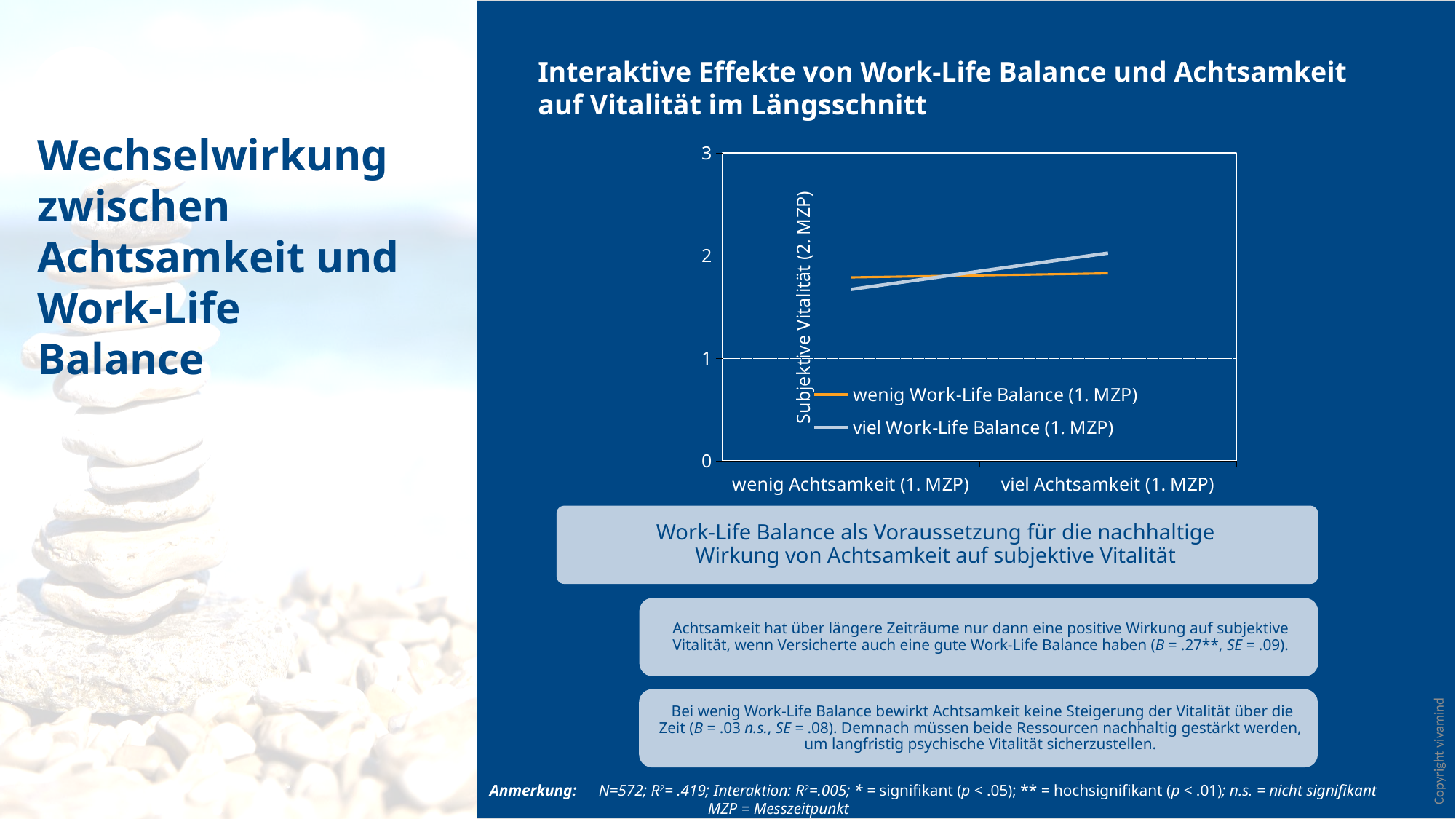
Does the line for 'viel Work-Life Balance (1. MZP)' rise or fall from 'wenig Achtsamkeit (1. MZP)' to 'viel Achtsamkeit (1. MZP)'? rise What kind of chart is shown on the slide? line chart How many series does the chart legend list? 2 What is the label of the y axis of the chart? Subjektive Vitalität (2. MZP) Is the value for 'viel Work-Life Balance (1. MZP)' at 'viel Achtsamkeit (1. MZP)' greater or less than 3? less Is the value for 'wenig Work-Life Balance (1. MZP)' at 'wenig Achtsamkeit (1. MZP)' greater or less than 2? less Is the value for 'wenig Work-Life Balance (1. MZP)' at 'viel Achtsamkeit (1. MZP)' greater or less than 1? greater What is the title of the chart? Interaktive Effekte von Work-Life Balance und Achtsamkeit auf Vitalität im Längsschnitt At 'viel Achtsamkeit (1. MZP)', which series has the higher value: 'wenig Work-Life Balance (1. MZP)' or 'viel Work-Life Balance (1. MZP)'? viel Work-Life Balance (1. MZP) How many categories are shown on the x axis of the chart? 2 At 'wenig Achtsamkeit (1. MZP)', which series has the higher value: 'wenig Work-Life Balance (1. MZP)' or 'viel Work-Life Balance (1. MZP)'? wenig Work-Life Balance (1. MZP)